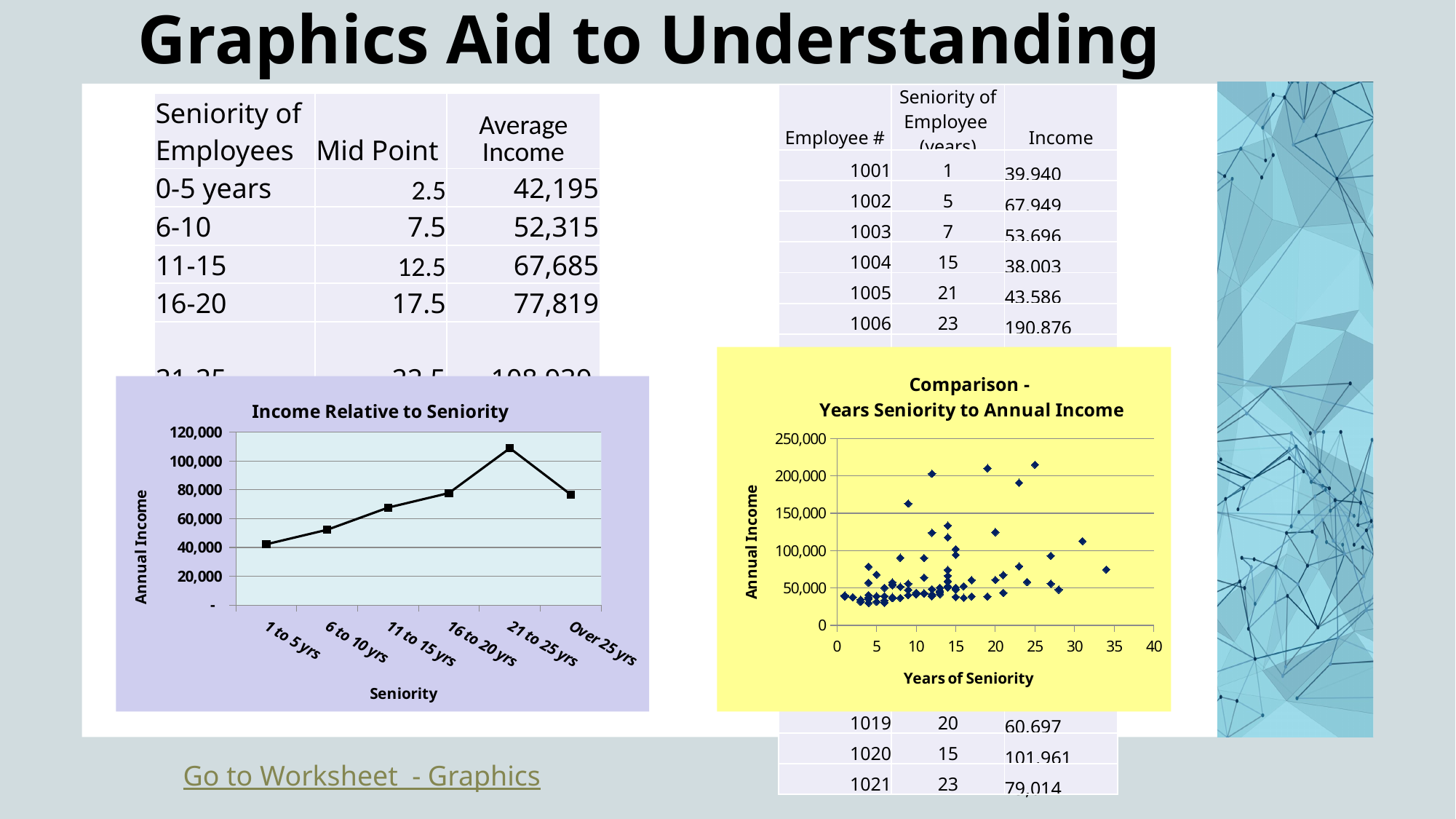
In the "Income Relative to Seniority" chart, how does annual income change from 1 to 5 yrs through 21 to 25 yrs? It rises What kind of chart is "Comparison - Years Seniority to Annual Income"? scatter chart What kind of chart is "Income Relative to Seniority"? line chart In the "Income Relative to Seniority" chart, is the value for 11 to 15 yrs greater or less than 60,000? greater How many seniority categories are plotted on the x axis of the "Income Relative to Seniority" chart? 6 In the "Income Relative to Seniority" chart, is the value for 21 to 25 yrs greater or less than 100,000? greater In the "Income Relative to Seniority" chart, which seniority category has the highest annual income? 21 to 25 yrs In the "Income Relative to Seniority" chart, which seniority category has the lowest annual income? 1 to 5 yrs In the "Income Relative to Seniority" chart, is the value for 6 to 10 yrs greater or less than 60,000? less What is the highest value shown on the y axis of the "Comparison - Years Seniority to Annual Income" chart? 250,000 What is the x-axis title of the "Comparison - Years Seniority to Annual Income" chart? Years of Seniority In the "Income Relative to Seniority" chart, which is larger, the value for 21 to 25 yrs or the value for Over 25 yrs? 21 to 25 yrs